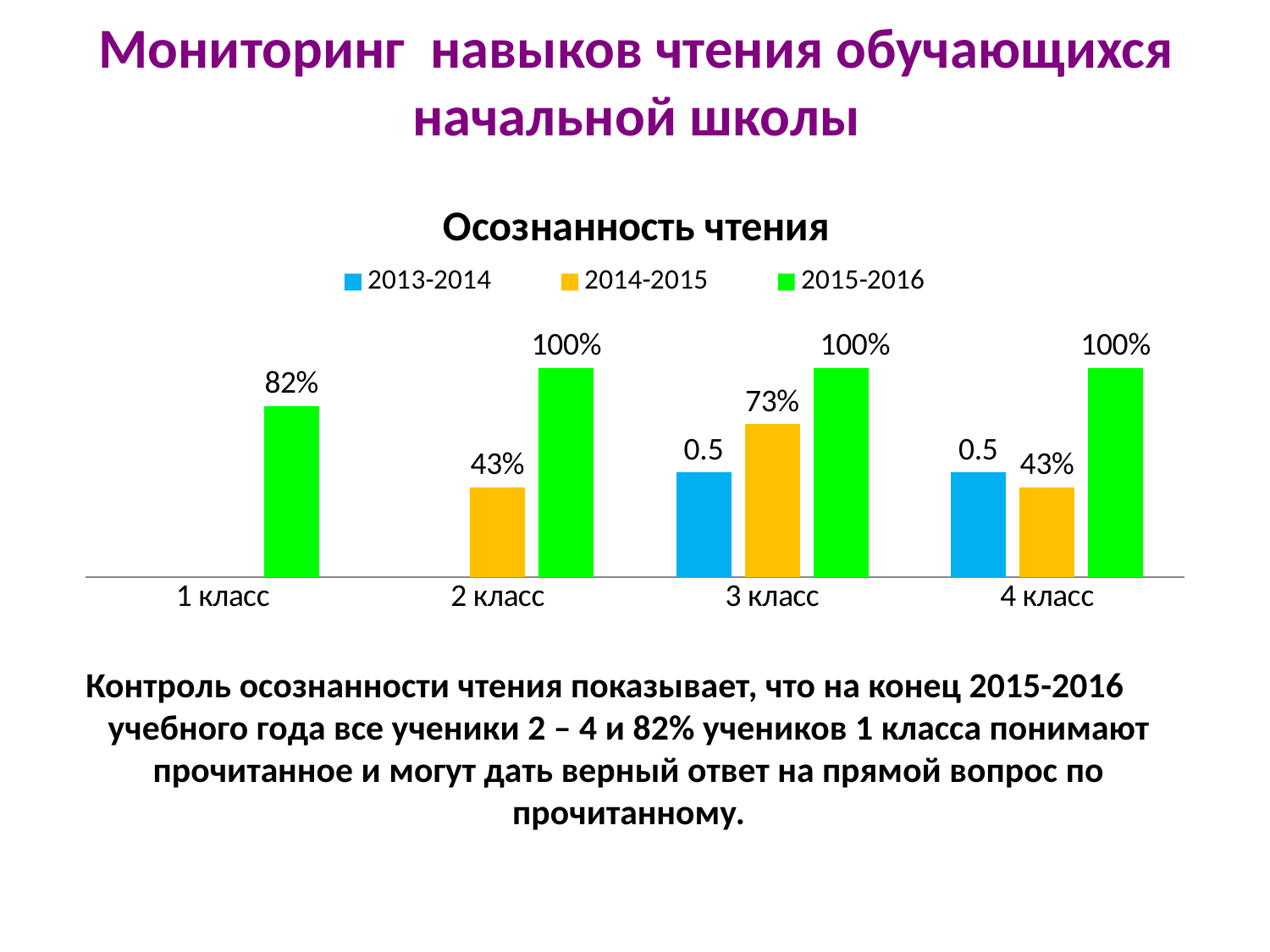
Which is larger in 2 класс: the 2014-2015 value or the 2015-2016 value? 2015-2016 What is the value for 2014-2015 in 2 класс? 43% Which class has the lowest value for the 2015-2016 series? 1 класс What type of chart is shown? Bar chart How many series does the legend list? 3 What is the value for 2015-2016 in 4 класс? 100% What is the value for 2013-2014 in 4 класс? 0.5 What is the value for 2015-2016 in 1 класс? 82% What is the value for 2014-2015 in 3 класс? 73% What is the difference between the 2014-2015 values for 3 класс and 4 класс? 30% How many classes are shown on the x axis? 4 Which class has the highest value for the 2014-2015 series? 3 класс